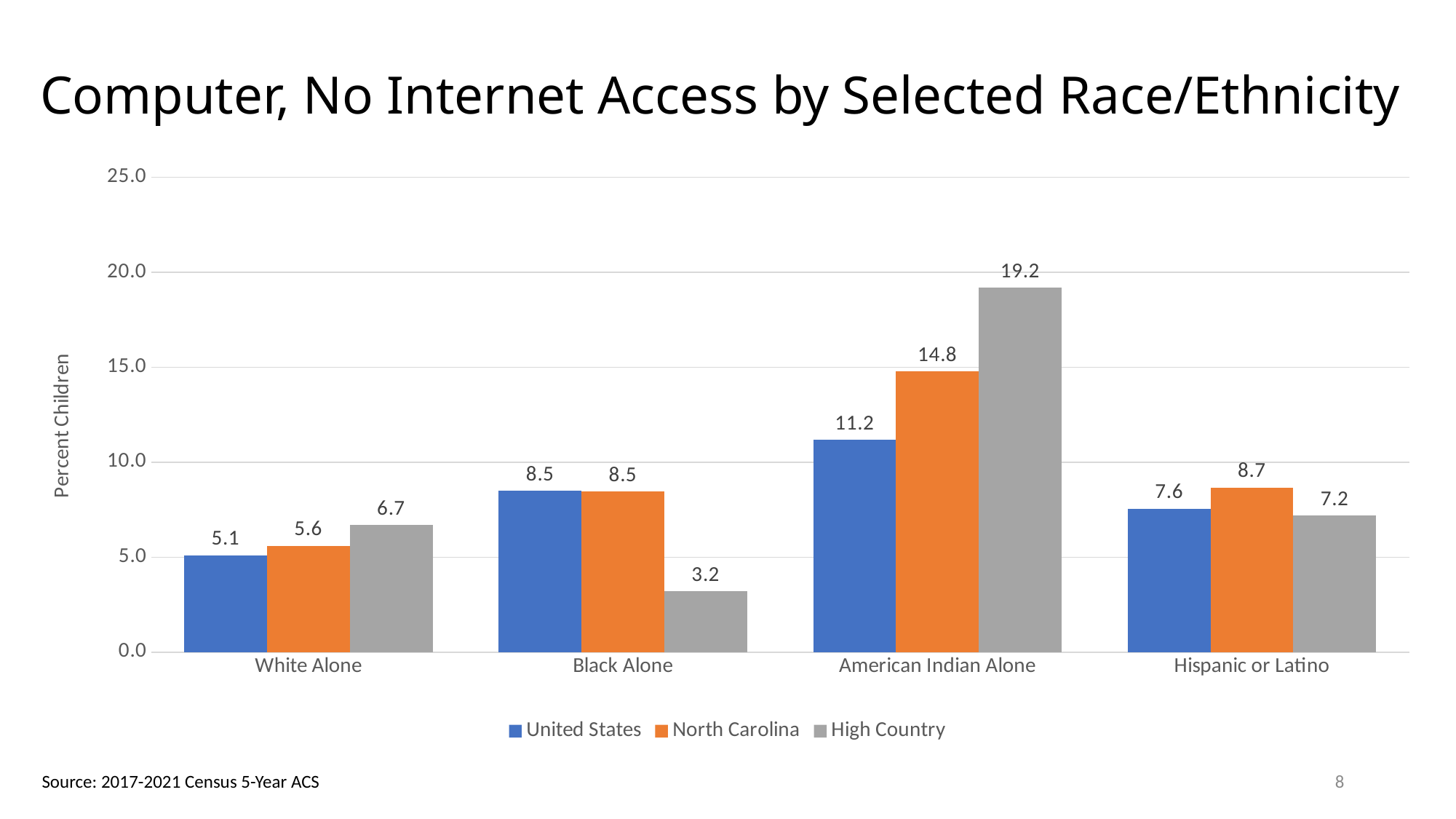
What is the North Carolina value for Hispanic or Latino? 8.7 What type of chart is shown on the slide? bar chart How many series does the legend list? 3 Which category has the lowest United States value? White Alone Which is larger for Hispanic or Latino: the North Carolina value or the High Country value? North Carolina What is the United States value for White Alone? 5.1 Is the North Carolina value for American Indian Alone greater or less than 10.0? greater What is the difference between the High Country and United States values for American Indian Alone? 8.0 What is the High Country value for American Indian Alone? 19.2 Which category has the highest High Country value? American Indian Alone What is the High Country value for Black Alone? 3.2 How many race/ethnicity categories are shown on the x axis? 4